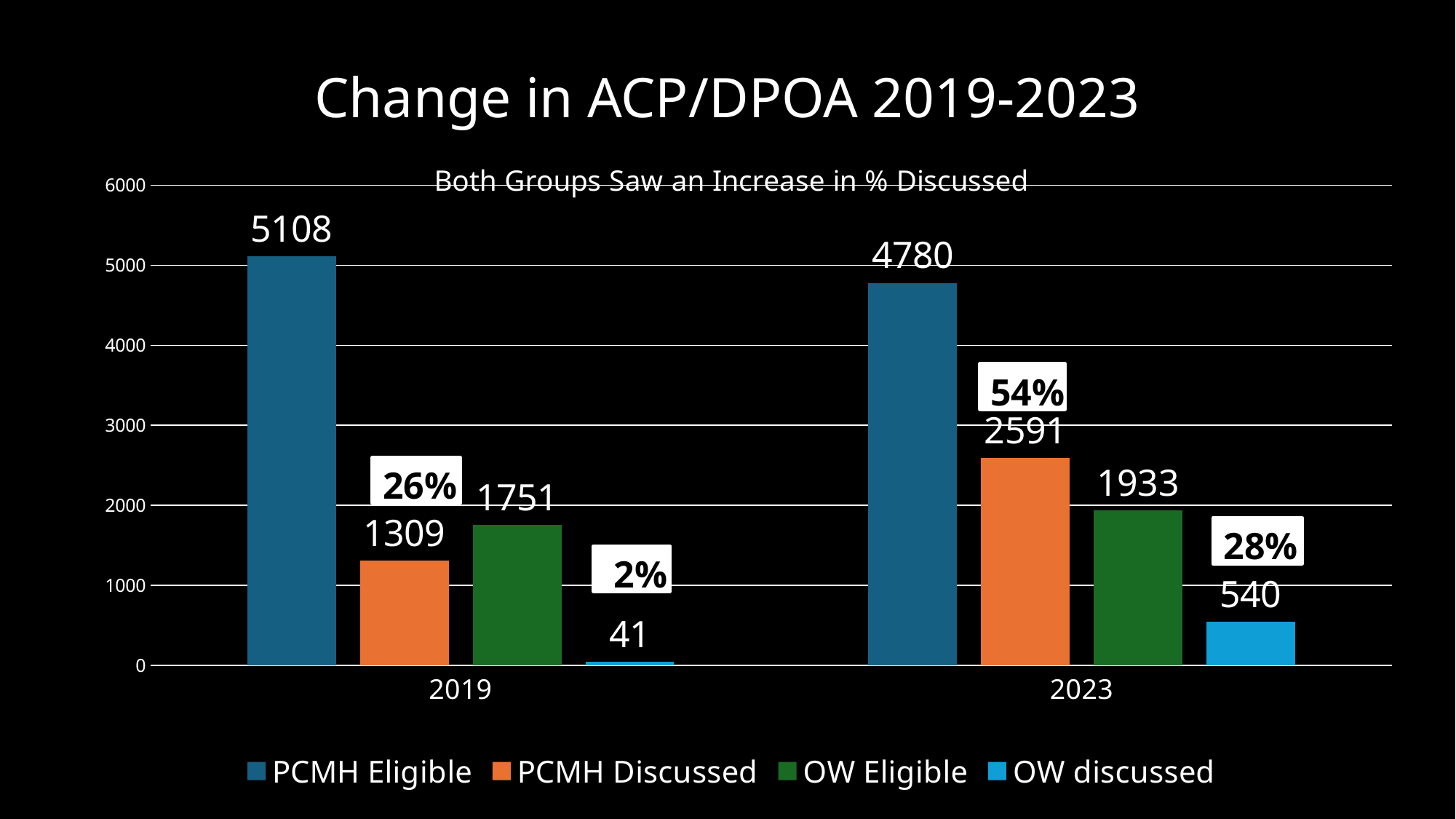
What is the value for PCMH Discussed in 2023? 2591 Which series has the highest value in 2023? PCMH Eligible What kind of chart is shown on the slide? Bar chart What is the difference between PCMH Eligible in 2019 and PCMH Eligible in 2023? 328 What is the value for OW discussed in 2023? 540 What is the value for PCMH Eligible in 2019? 5108 How many series does the legend list? 4 Which series has the lowest value in 2019? OW discussed What is the value for OW Eligible in 2019? 1751 What percentage label is shown above the PCMH Discussed bar for 2023? 54% Which is larger, PCMH Discussed in 2019 or OW Eligible in 2019? OW Eligible in 2019 What is the difference between OW discussed in 2023 and OW discussed in 2019? 499